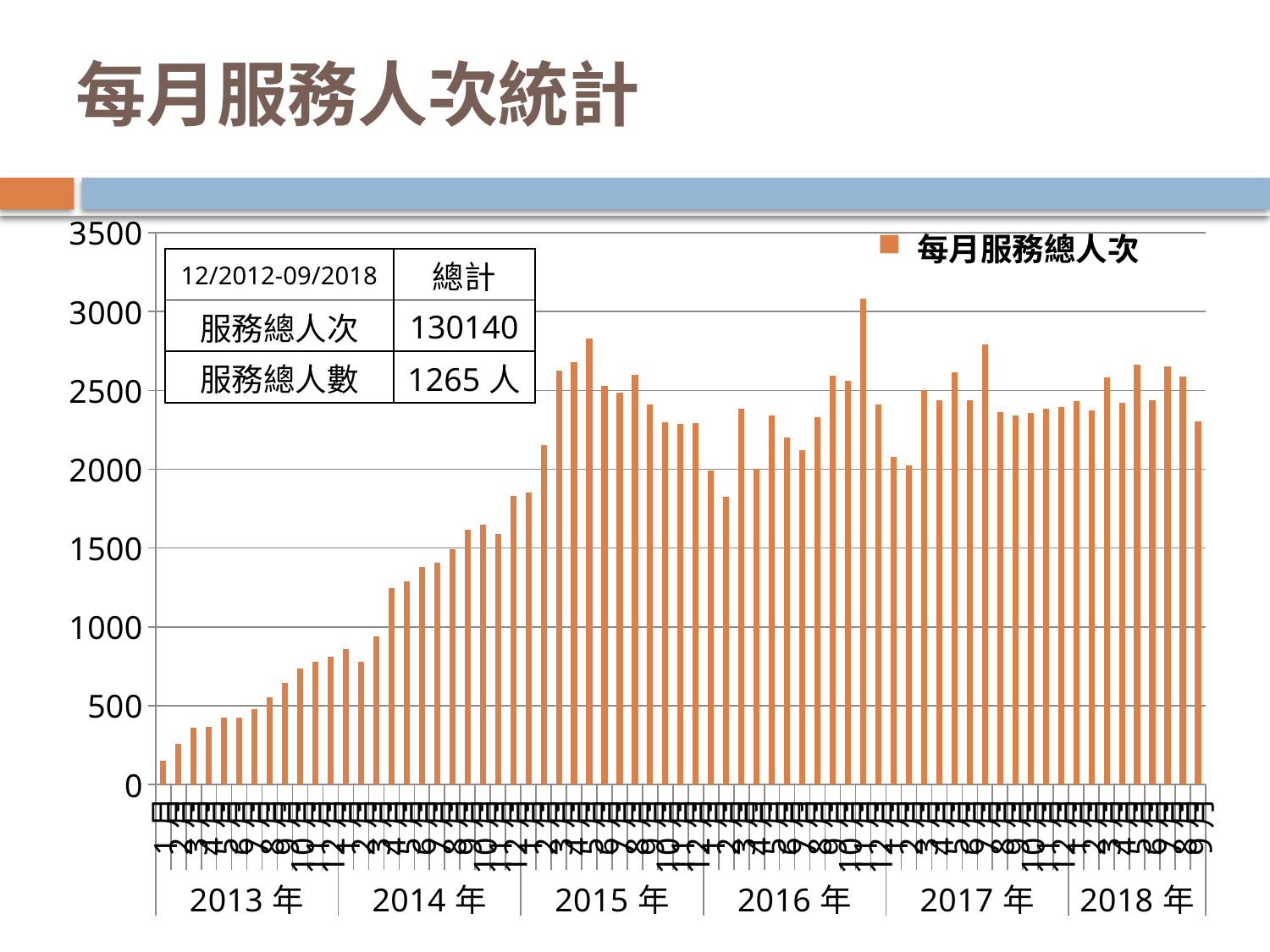
Is the first bar in the chart (the leftmost, for 2013 年) greater or less than 500? less Are the bars in the 2013 年 group taller or shorter than the bars in the 2017 年 group? shorter Which year group on the x axis contains the shortest bar in the chart? 2013 年 How many year groups are labelled along the x axis of the chart? 6 Do the bar values rise or fall across the 2013 年 group from left to right? rise Is the tallest bar in the chart greater or less than 3000? greater How many series does the chart legend list? 1 Which year group on the x axis contains the tallest bar in the chart? 2016 年 What kind of chart is shown on the slide? bar chart What is the name of the series shown in the chart legend? 每月服務總人次 According to the table on the chart, what is the total 服務總人次 for 12/2012-09/2018? 130140 According to the table on the chart, what is the total 服務總人數 for 12/2012-09/2018? 1265 人